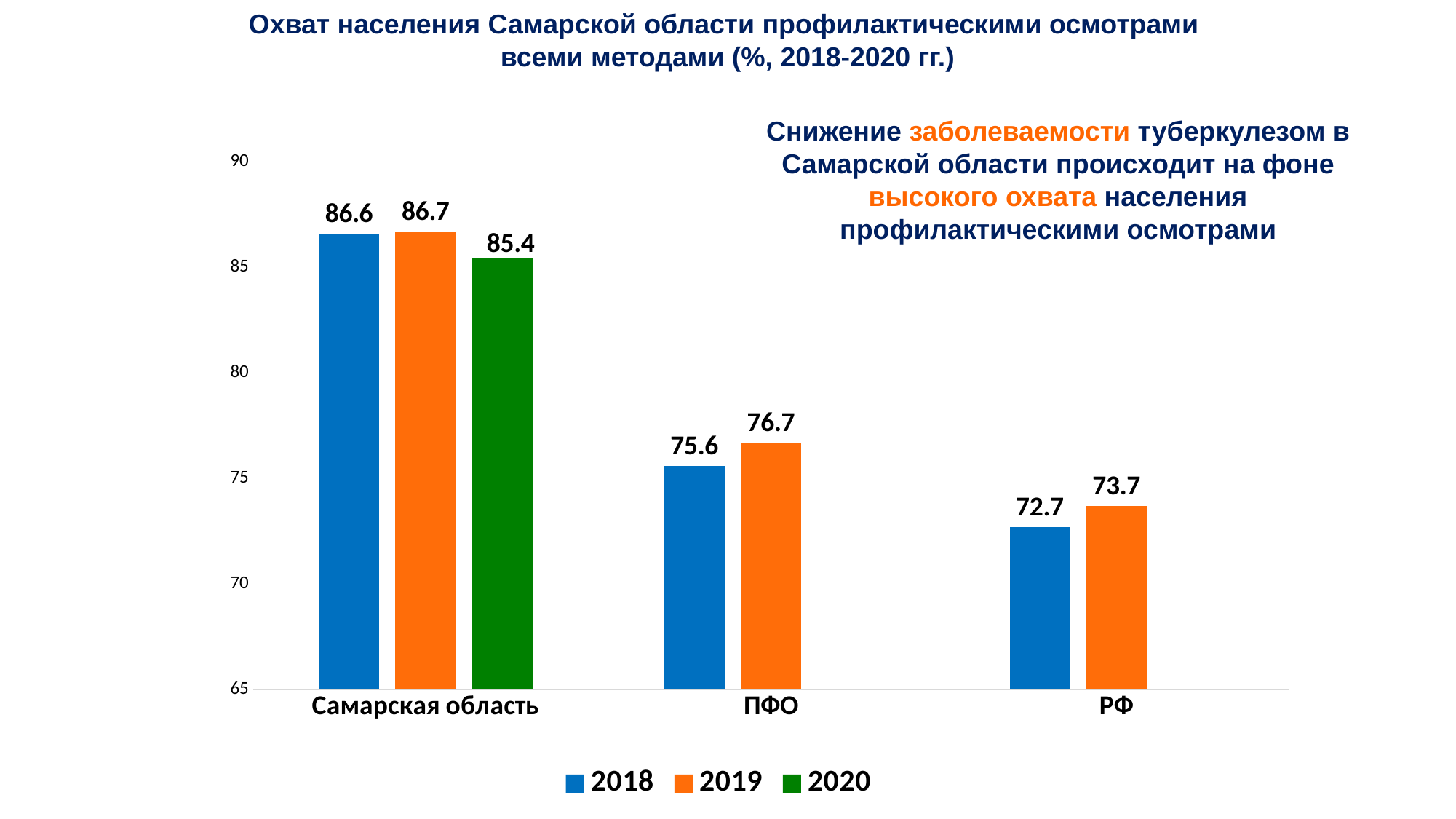
Which category has the lowest value in 2018? РФ What kind of chart is shown on the slide? Bar chart What is the value for Самарская область in 2020? 85.4 How many categories are shown on the x axis? 3 What is the value for Самарская область in 2018? 86.6 What is the value for ПФО in 2019? 76.7 What is the difference between the 2019 values for Самарская область and РФ? 13 What is the value for РФ in 2018? 72.7 Which is larger: the 2018 value for ПФО or the 2019 value for РФ? 2018 value for ПФО What is the difference between the 2018 and 2019 values for ПФО? 1.1 Which category has the highest value in 2019? Самарская область How many series does the legend list? 3